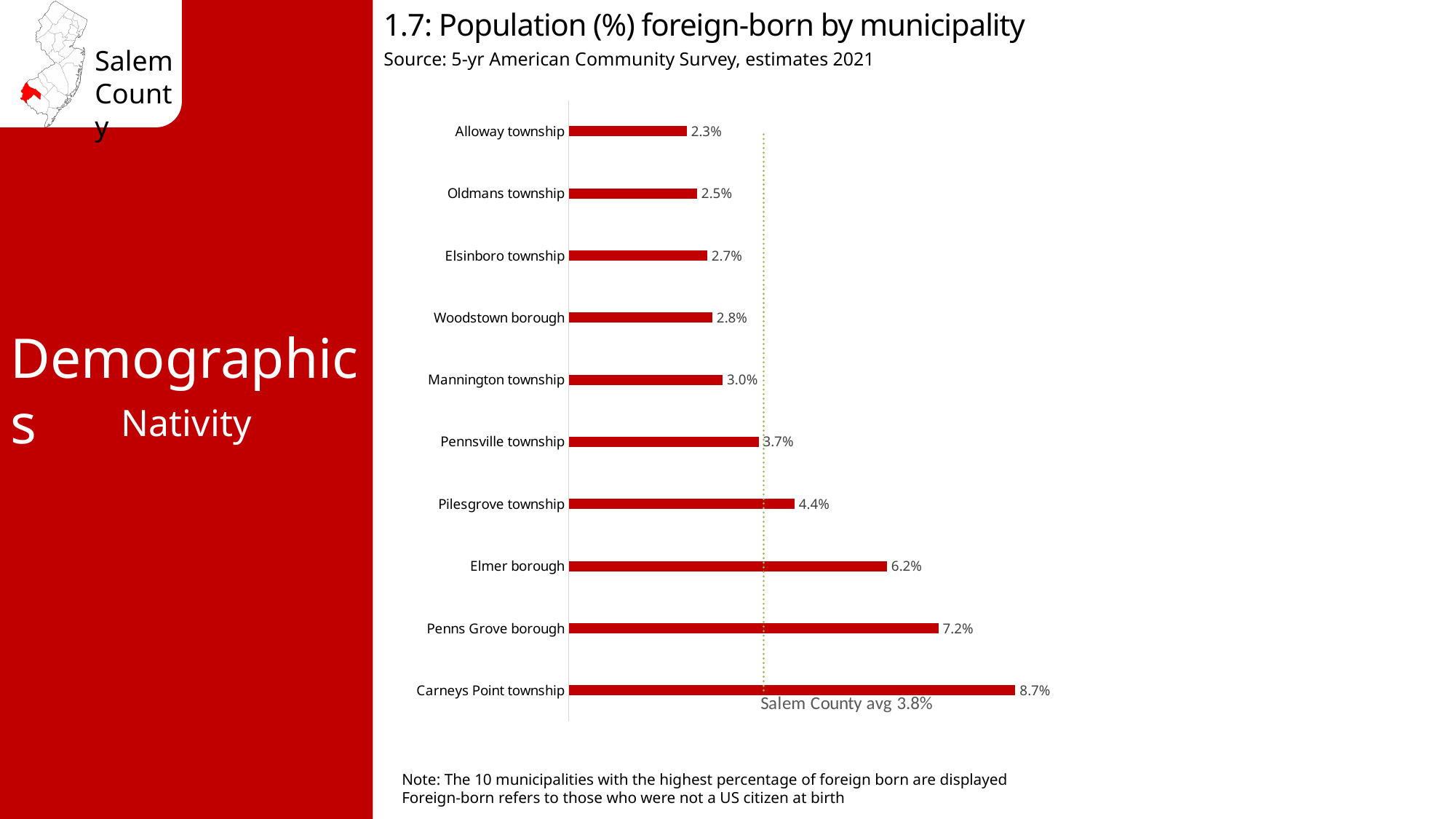
Which municipality has the highest foreign-born percentage? Carneys Point township What is the foreign-born percentage for Pilesgrove township? 4.4% Which municipality has the lowest foreign-born percentage? Alloway township What is the foreign-born percentage for Carneys Point township? 8.7% What kind of chart is shown on the slide? Bar chart What is the foreign-born percentage for Alloway township? 2.3% What is the difference between the foreign-born percentages of Penns Grove borough and Elmer borough? 1.0% How many municipalities are shown in the chart? 10 What is the Salem County average foreign-born percentage marked by the dotted line? 3.8% What is the difference between the foreign-born percentages of Carneys Point township and Alloway township? 6.4% Which has a higher foreign-born percentage, Pennsville township or Mannington township? Pennsville township What is the source of the data shown in the chart? 5-yr American Community Survey, estimates 2021